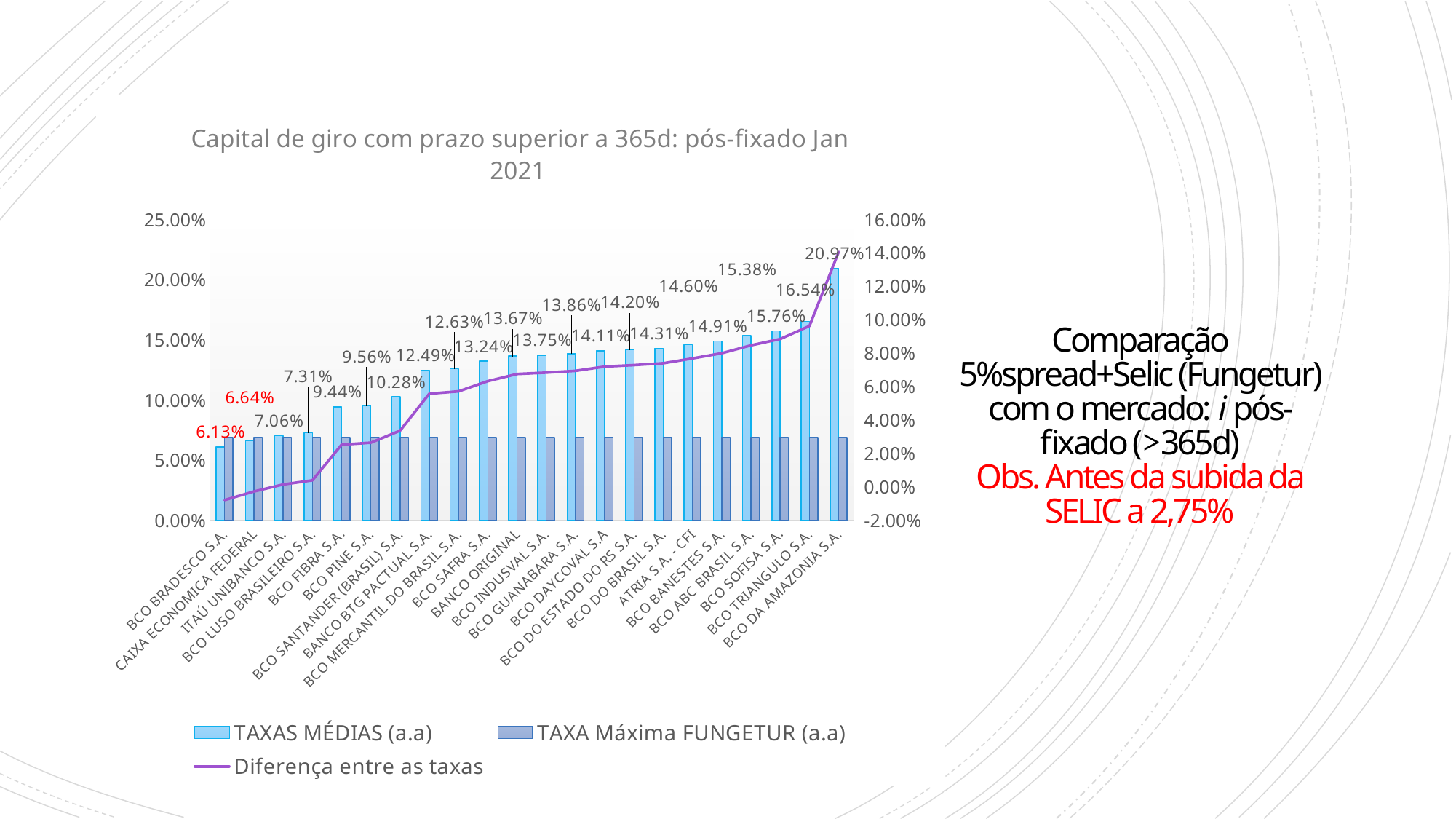
Which has a higher TAXAS MÉDIAS (a.a) value, BCO SAFRA S.A. or BCO PINE S.A.? BCO SAFRA S.A. What is the difference between the TAXAS MÉDIAS (a.a) values of BCO TRIANGULO S.A. and BCO SOFISA S.A.? 0.78% Which bank has the lowest TAXAS MÉDIAS (a.a) value? BCO BRADESCO S.A. What kind of chart is shown on the slide? Combination bar and line chart What is the TAXAS MÉDIAS (a.a) value for BCO BRADESCO S.A.? 6.13% Which bank has the highest TAXAS MÉDIAS (a.a) value? BCO DA AMAZONIA S.A. What is the difference between the TAXAS MÉDIAS (a.a) values of BCO DA AMAZONIA S.A. and BCO BRADESCO S.A.? 14.84% What is the TAXAS MÉDIAS (a.a) value for BCO DA AMAZONIA S.A.? 20.97% What is the TAXAS MÉDIAS (a.a) value for BCO SANTANDER (BRASIL) S.A.? 10.28% How many series does the chart legend list? 3 How many banks are shown on the x axis of the chart? 22 Do the TAXAS MÉDIAS (a.a) values rise or fall from left to right along the x axis? Rise